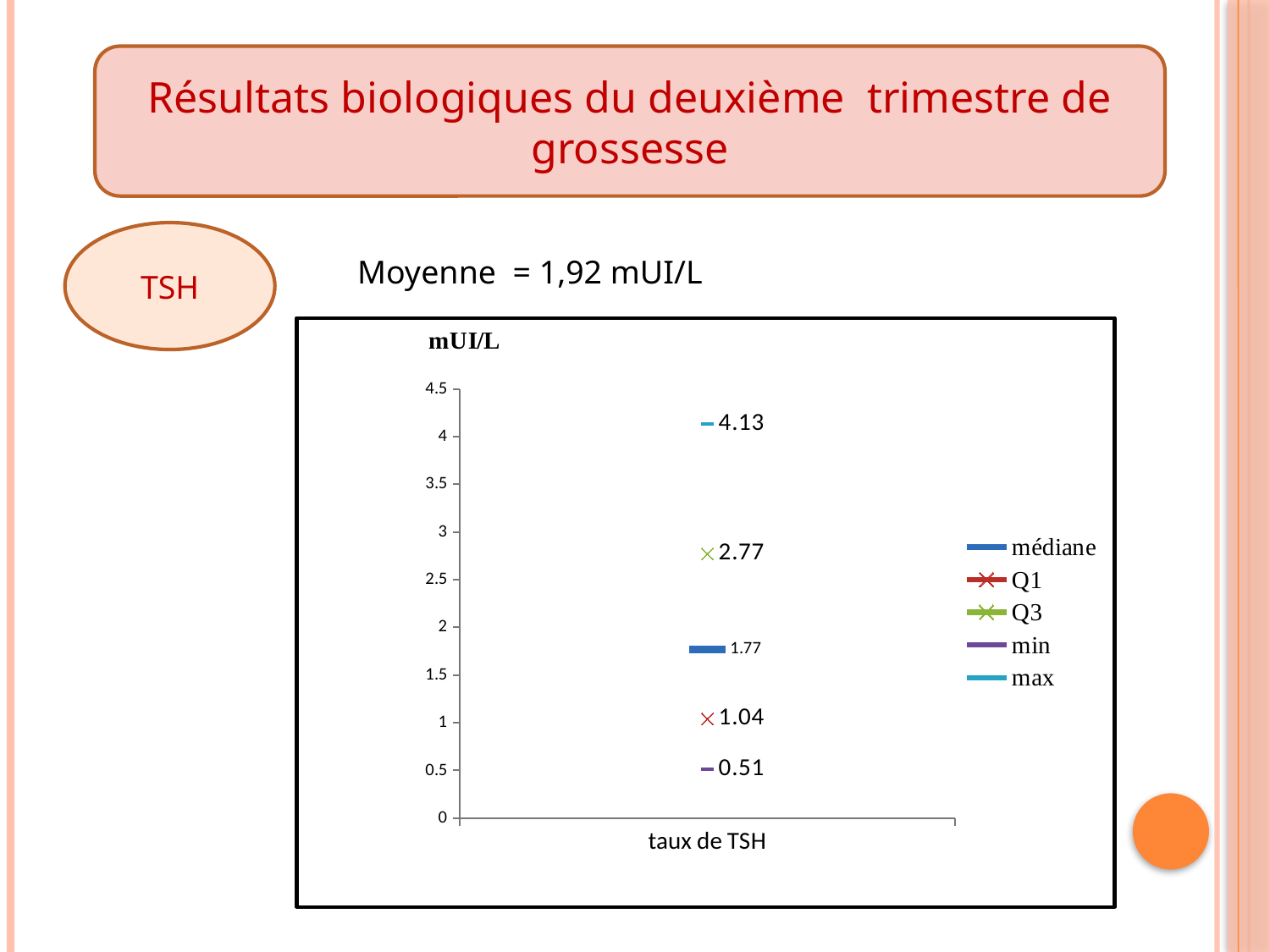
What is the value of the médiane series for taux de TSH? 1.77 Which series has the lowest plotted value? min What is the category label shown on the x axis? taux de TSH What is the value of the Q3 series for taux de TSH? 2.77 What is the difference between the Q3 value and the Q1 value? 1.73 What is the value of the min series for taux de TSH? 0.51 How many series does the legend list? 5 What is the difference between the max value and the min value? 3.62 Which is larger, the Q3 value or the médiane value? Q3 What is the value of the Q1 series for taux de TSH? 1.04 What is the value of the max series for taux de TSH? 4.13 Which series has the highest plotted value? max